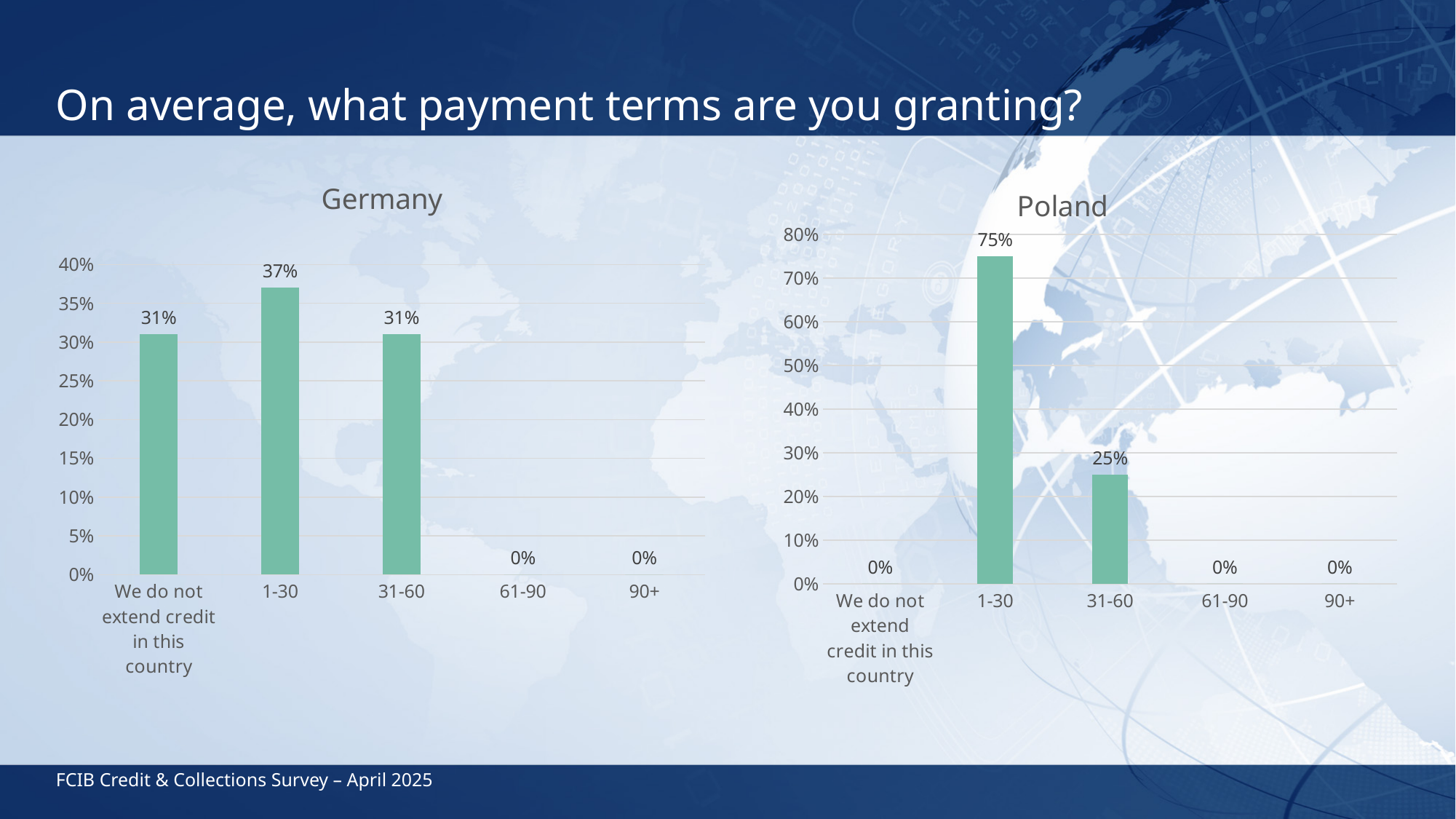
In the Germany chart, what is the difference between the values for 1-30 and 31-60? 6% Which is larger: the value for 1-30 in the Germany chart or the value for 1-30 in the Poland chart? Poland What kind of chart is the Germany chart? Bar chart In the Poland chart, which category has the highest value? 1-30 In the Poland chart, what is the value for 31-60? 25% In the Germany chart, how many categories have a value of 0%? 2 How many categories are shown on the x axis of the Poland chart? 5 In the Poland chart, what is the value for 1-30? 75% In the Poland chart, what is the difference between the values for 1-30 and 31-60? 50% In the Germany chart, what is the value for 'We do not extend credit in this country'? 31% In the Germany chart, which category has the highest value? 1-30 In the Germany chart, what is the value for 1-30? 37%